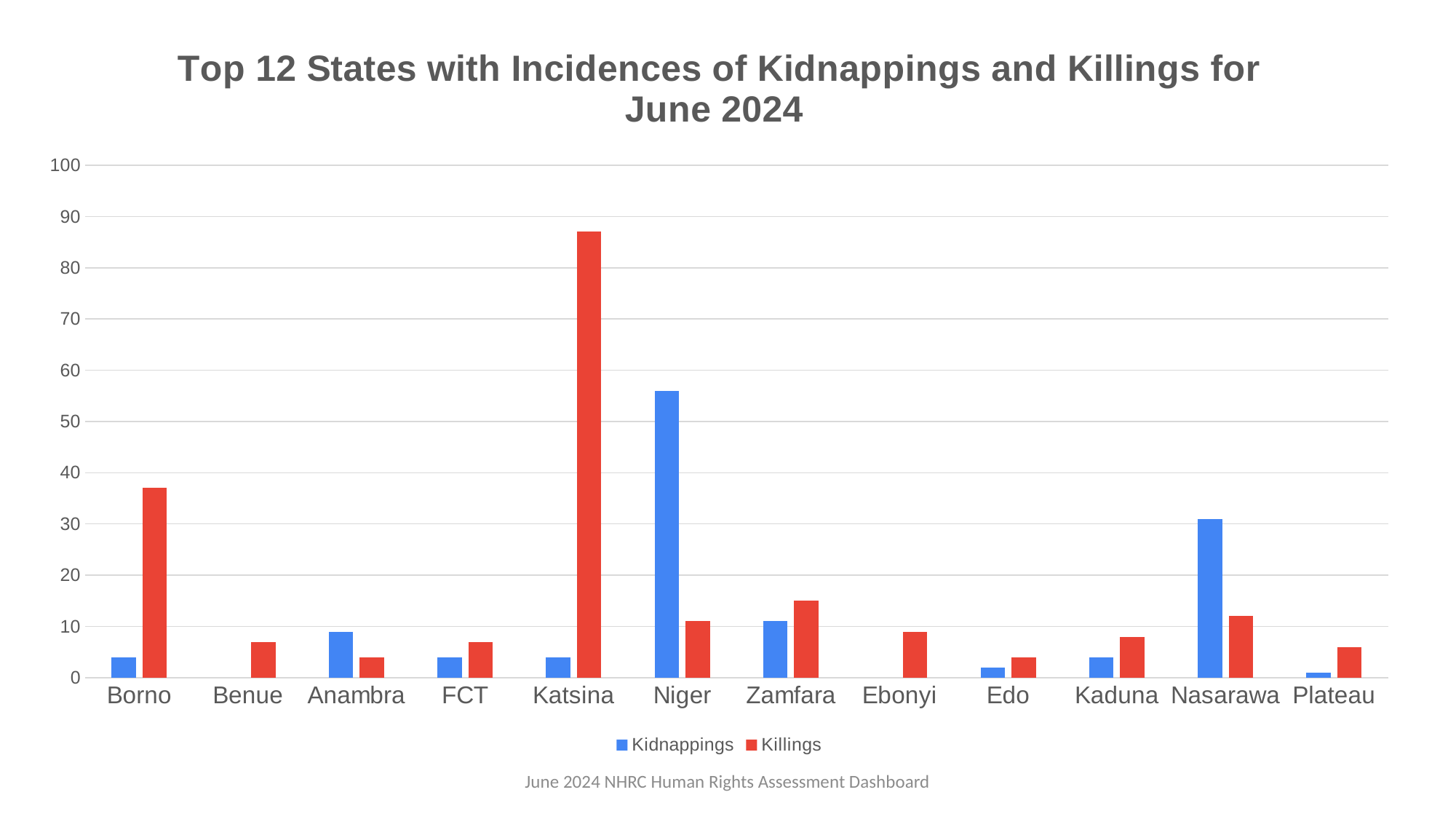
How many series does the legend list? 2 How many states are shown on the x axis of the chart? 12 Which state has the highest number of Kidnappings? Niger Which state has the highest number of Killings? Katsina Is the Killings value for Borno greater or less than 40? less For Borno, which is larger: Kidnappings or Killings? Killings Is the Kidnappings value for Niger greater or less than 50? greater Is the Kidnappings value for Nasarawa greater or less than 40? less For Niger, which is larger: Kidnappings or Killings? Kidnappings What kind of chart is shown on the slide? bar chart What colour are the Killings bars in the chart? red